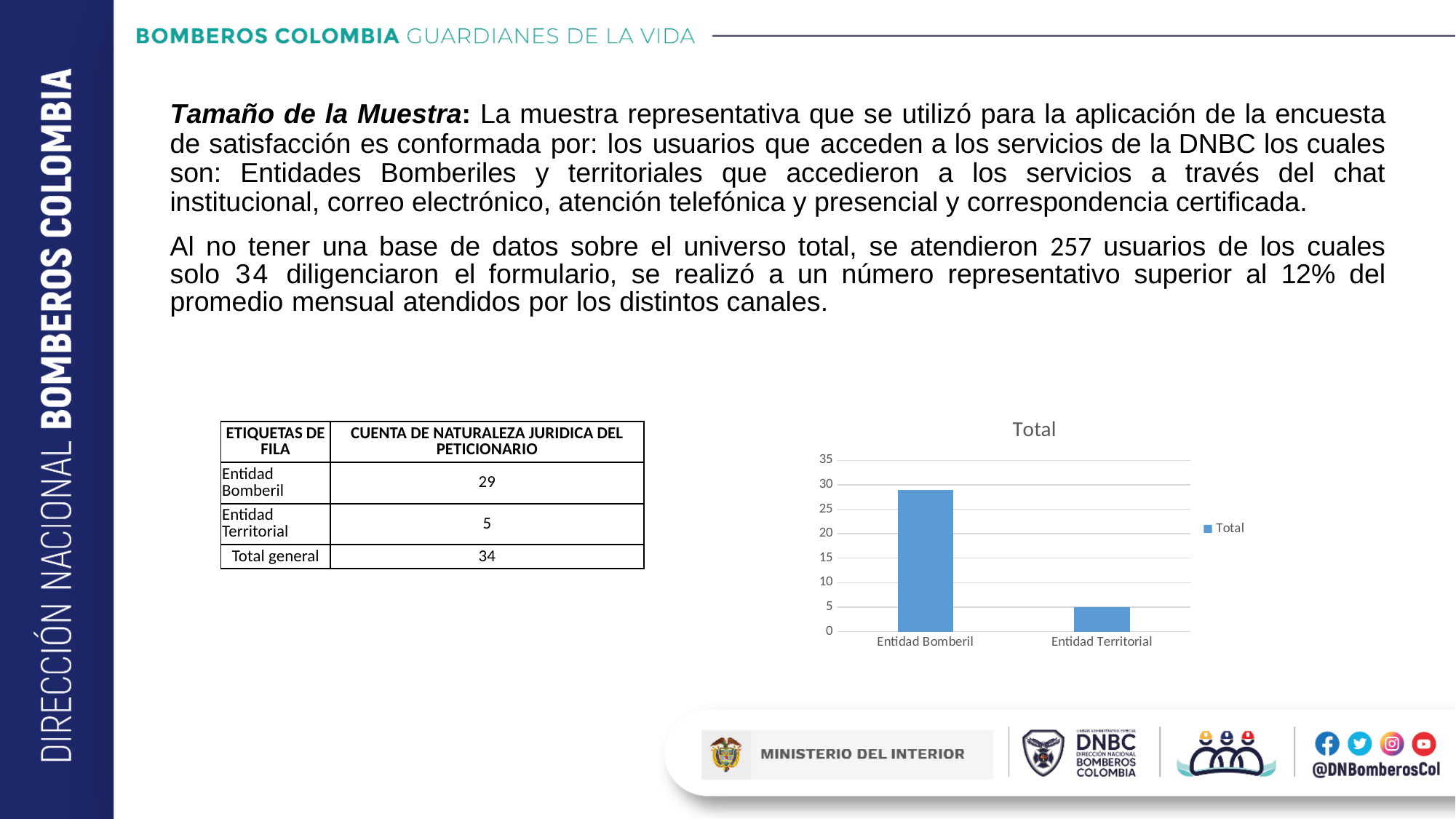
How many series does the chart legend list? 1 Which category has the highest bar in the chart? Entidad Bomberil Which is larger, the value for Entidad Bomberil or the value for Entidad Territorial? Entidad Bomberil Is the value for Entidad Bomberil greater or less than 25? greater How many categories are plotted on the x axis of the chart? 2 What is the value for Entidad Bomberil in the chart? 29 What is the difference between the values for Entidad Bomberil and Entidad Territorial? 24 Which category has the lowest bar in the chart? Entidad Territorial What type of chart is shown on the slide? bar chart Is the value for Entidad Territorial greater or less than 10? less What is the value for Entidad Territorial in the chart? 5 What is the title of the chart? Total